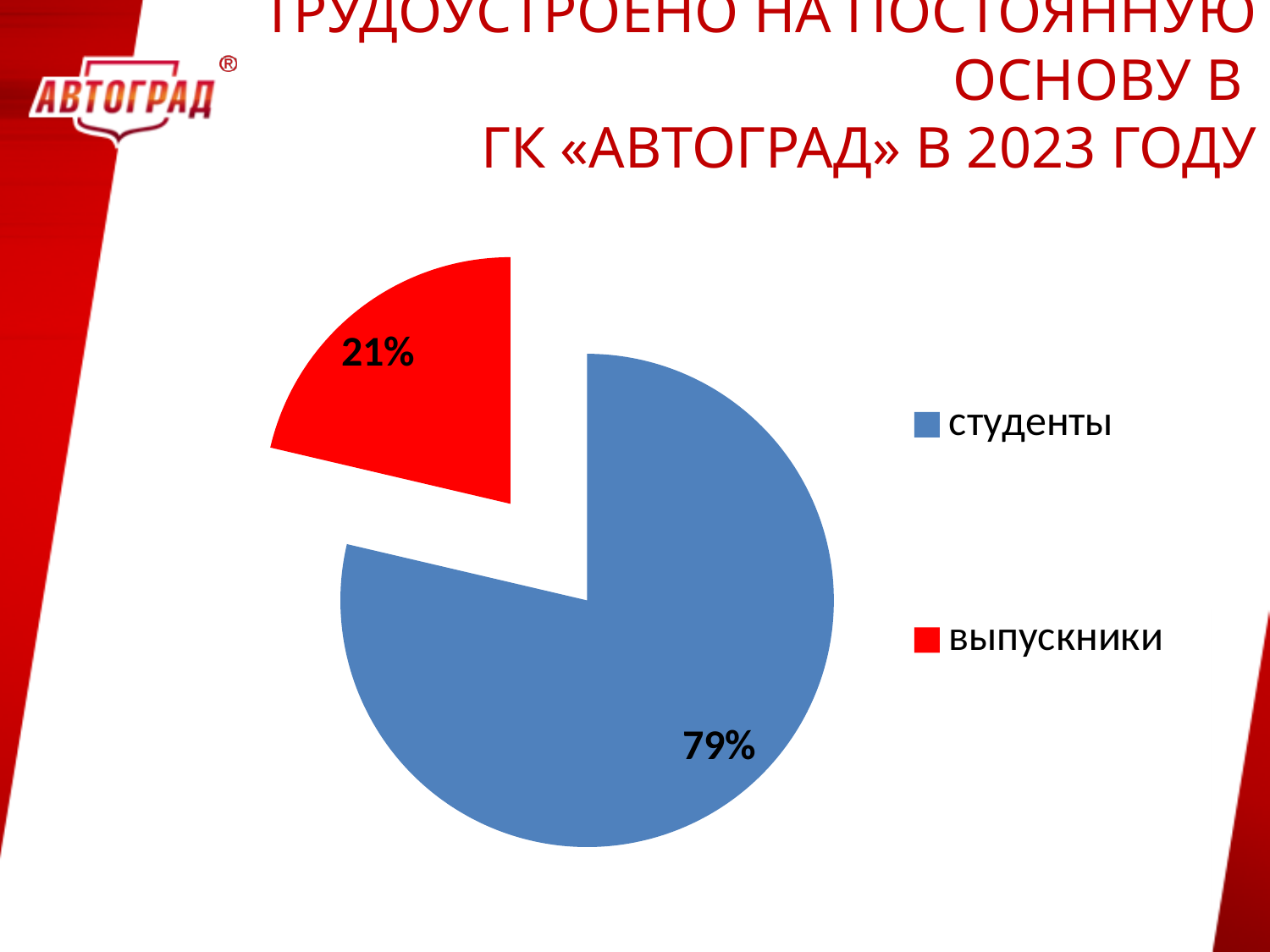
How many entries does the legend list? 2 Which category has the smallest slice in the pie chart? выпускники What share of the pie chart is labelled "выпускники"? 21% What colour is the "студенты" slice? blue How many slices does the pie chart have? 2 What share of the pie chart is labelled "студенты"? 79% What kind of chart is shown on the slide? pie chart Which category has the largest slice in the pie chart? студенты What colour is the "выпускники" slice? red Which slice is larger, "студенты" or "выпускники"? студенты What is the difference in percentage points between the "студенты" and "выпускники" slices? 58